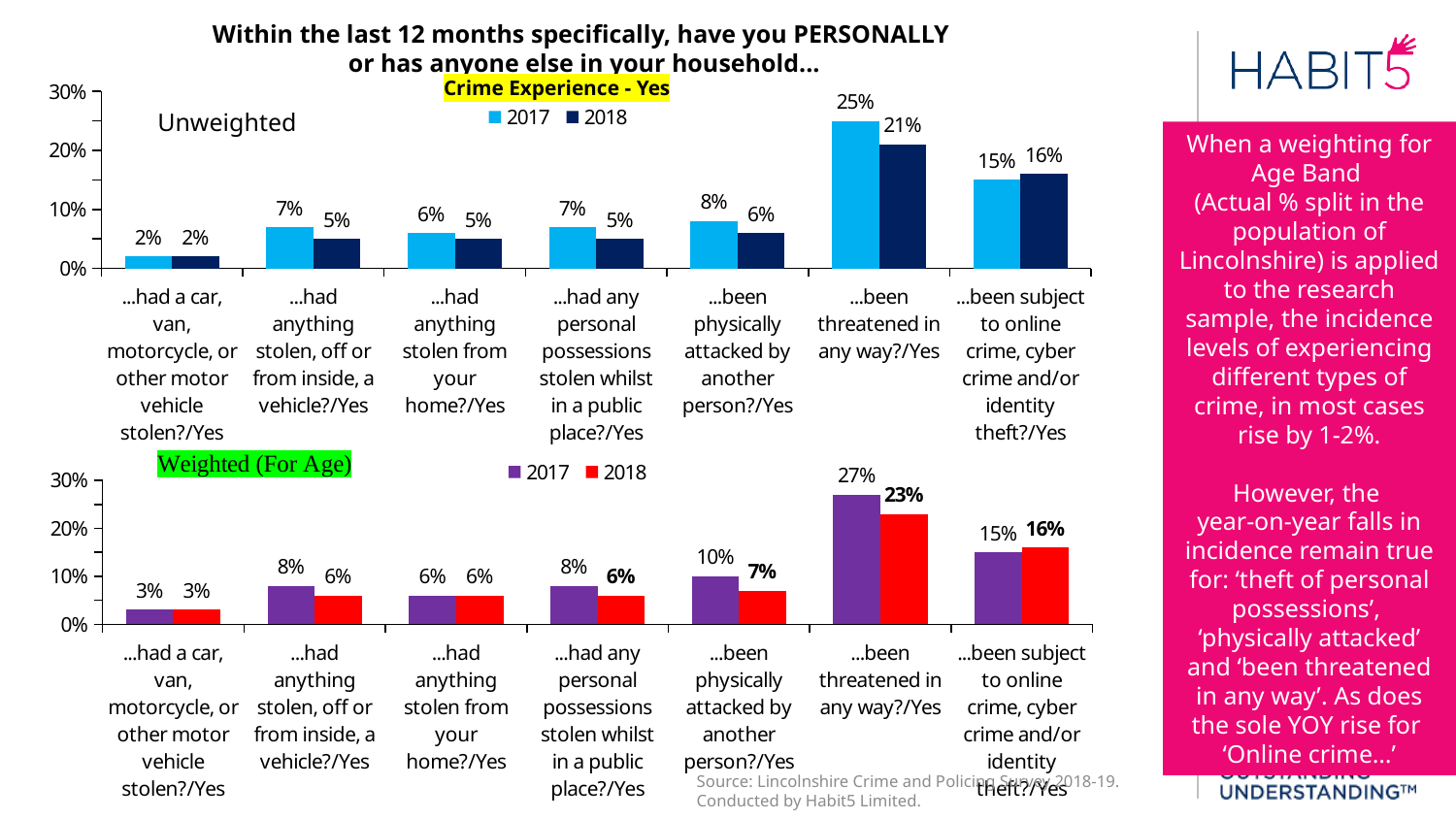
How many series does the legend of the Weighted (For Age) chart list? 2 In the Unweighted chart, which category has the lowest 2018 value? ...had a car, van, motorcycle, or other motor vehicle stolen?/Yes How many categories are shown on the x axis of the Unweighted chart? 7 What type of chart is the Unweighted chart? Bar chart In the Weighted (For Age) chart, is the 2017 value for '...been threatened in any way?/Yes' greater or less than 20%? greater In the Unweighted chart, what is the 2017 value for '...been threatened in any way?/Yes'? 25% In the Weighted (For Age) chart, what is the difference between the 2017 and 2018 values for '...been threatened in any way?/Yes'? 4% In the Unweighted chart, which is larger for '...been subject to online crime, cyber crime and/or identity theft?/Yes': the 2017 value or the 2018 value? 2018 In the Unweighted chart, what is the 2018 value for '...been subject to online crime, cyber crime and/or identity theft?/Yes'? 16% In the Weighted (For Age) chart, what is the 2018 value for '...been physically attacked by another person?/Yes'? 7% In the Weighted (For Age) chart, which category has the highest 2017 value? ...been threatened in any way?/Yes In the Weighted (For Age) chart, what colour represents the 2018 series? Red